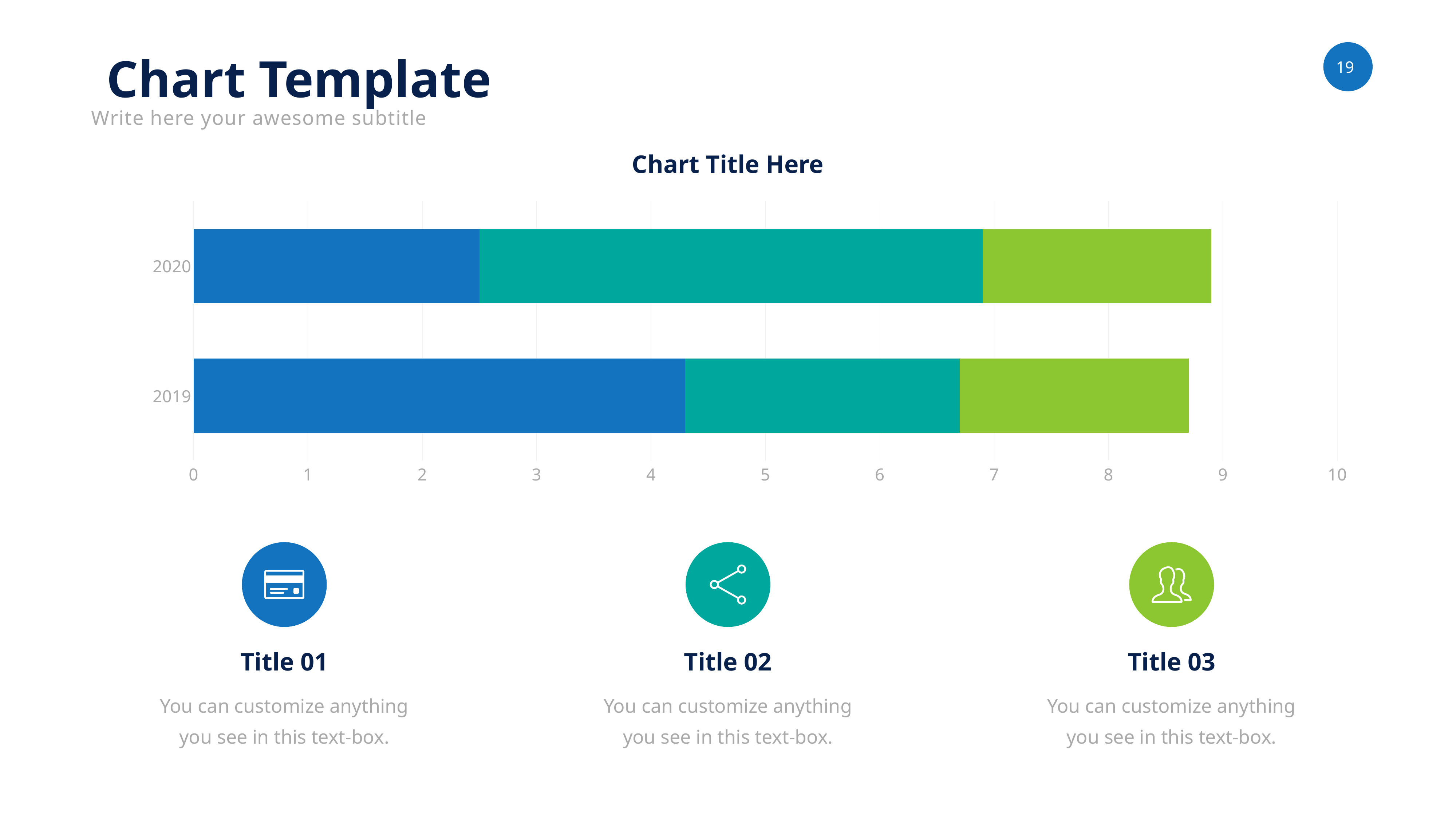
Is the total length of the 2019 bar greater or less than 9? less Is the blue segment for 2020 greater or less than 3? less What is the highest value shown on the horizontal axis of the chart? 10 How many coloured segments make up each bar in the chart? 3 Which year has the larger teal segment, 2019 or 2020? 2020 Which year has the larger blue segment, 2019 or 2020? 2019 How many categories (years) are shown on the vertical axis of the chart? 2 Is the blue segment for 2019 greater or less than 3? greater Which year is listed at the top of the vertical axis? 2020 What is the title of the chart? Chart Title Here What kind of chart is shown on the slide? bar chart